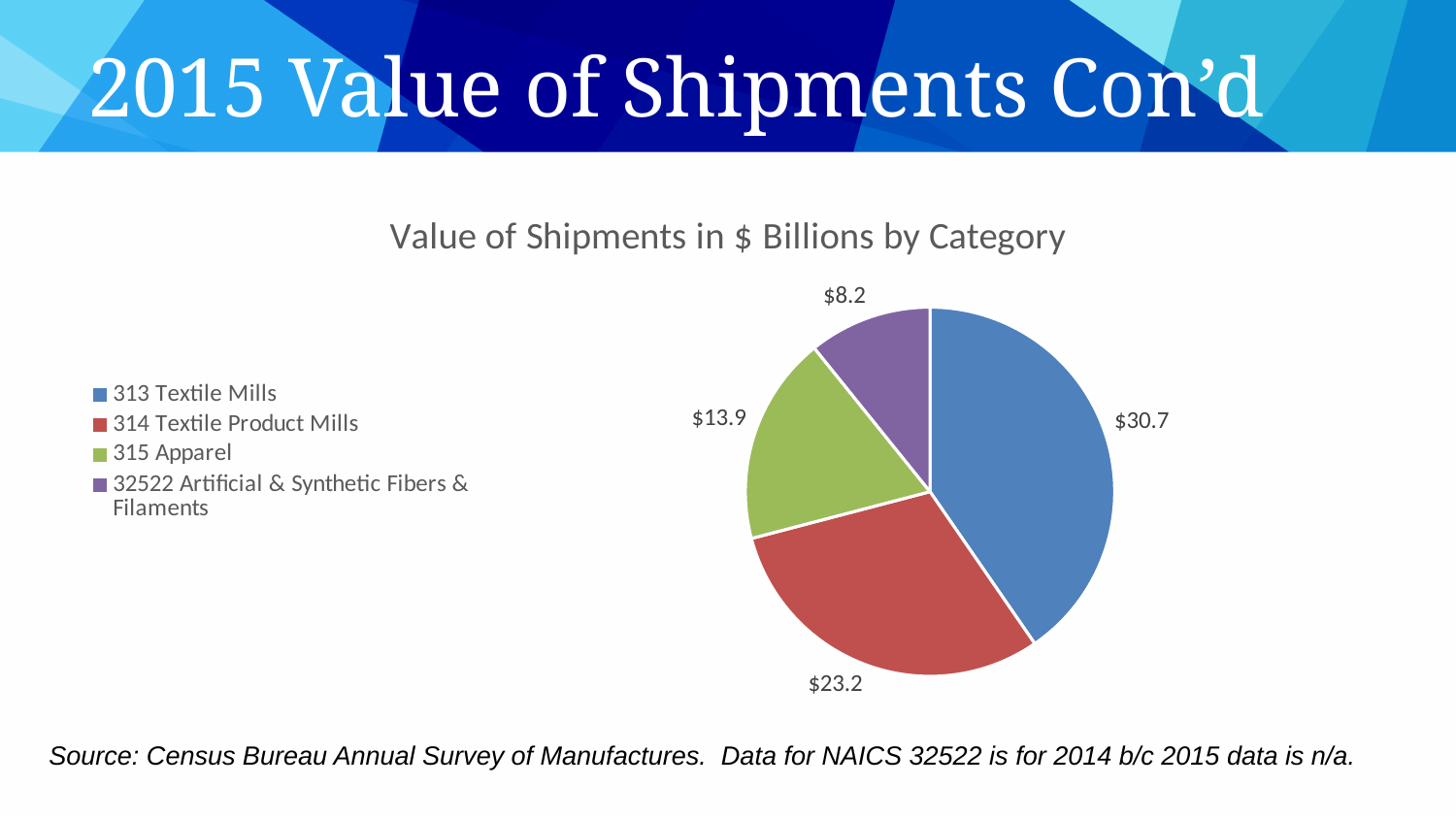
What is the total value of shipments across all four categories? $76.0 What kind of chart is shown on the slide? Pie chart What is the value of shipments for 314 Textile Product Mills? $23.2 What is the value of shipments for 32522 Artificial & Synthetic Fibers & Filaments? $8.2 What is the value of shipments for 315 Apparel? $13.9 Which has a larger value of shipments, 315 Apparel or 32522 Artificial & Synthetic Fibers & Filaments? 315 Apparel What is the title of the chart? Value of Shipments in $ Billions by Category How many categories are shown in the pie chart? 4 Which category has the highest value of shipments? 313 Textile Mills What is the value of shipments for 313 Textile Mills? $30.7 Which category has the lowest value of shipments? 32522 Artificial & Synthetic Fibers & Filaments What is the difference in value of shipments between 313 Textile Mills and 314 Textile Product Mills? $7.5